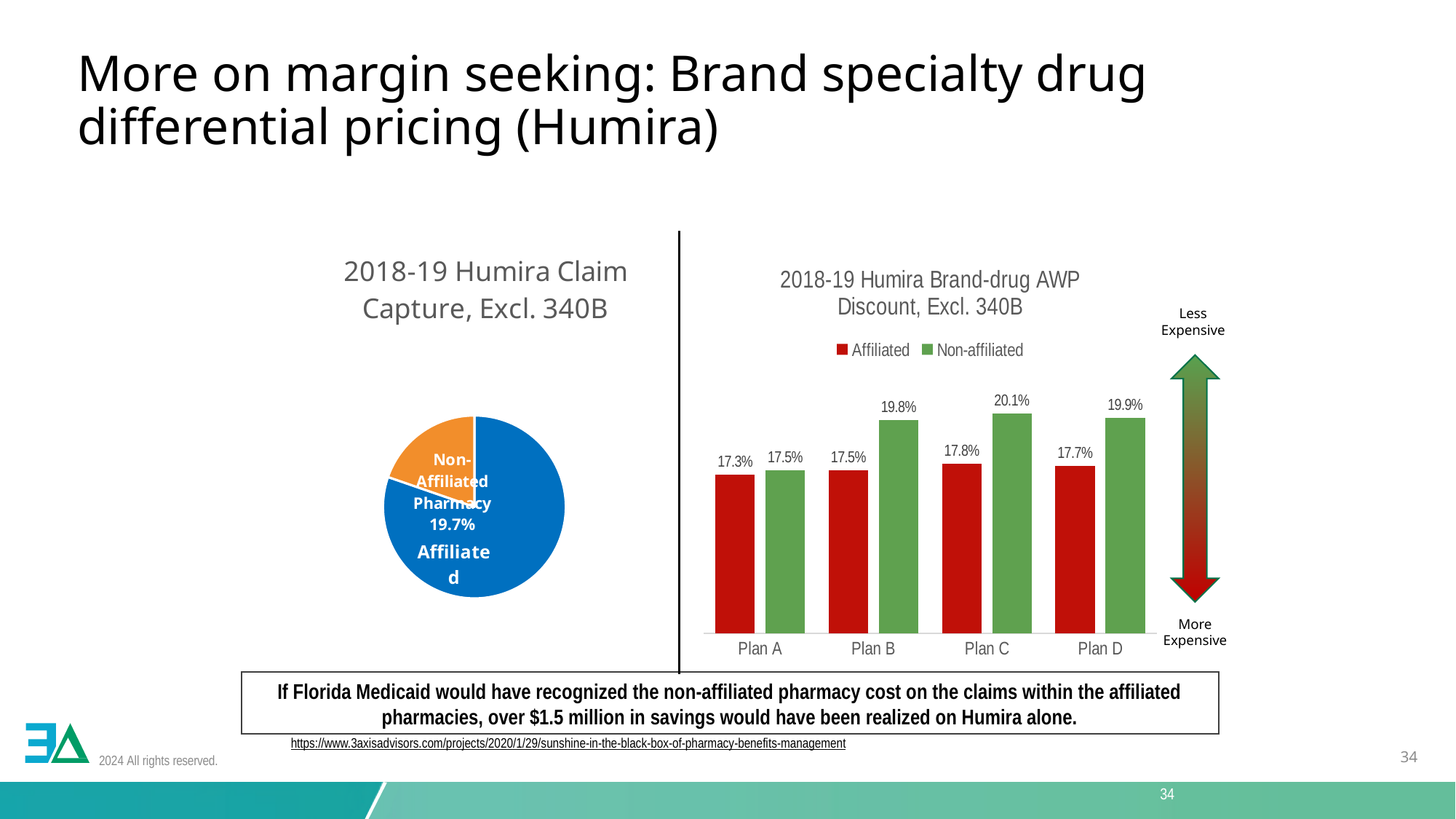
In the 2018-19 Humira Brand-drug AWP Discount chart, which plan has the lowest Affiliated discount? Plan A In the 2018-19 Humira Brand-drug AWP Discount chart, what is the Affiliated value for Plan A? 17.3% In the 2018-19 Humira Brand-drug AWP Discount chart, what is the difference between the Non-affiliated and Affiliated values for Plan B? 2.3% What kind of chart is the 2018-19 Humira Claim Capture, Excl. 340B chart? Pie chart How many series does the legend of the 2018-19 Humira Brand-drug AWP Discount chart list? 2 In the 2018-19 Humira Claim Capture pie chart, what share of claims is Non-Affiliated Pharmacy? 19.7% What kind of chart is the 2018-19 Humira Brand-drug AWP Discount, Excl. 340B chart? Bar chart In the 2018-19 Humira Brand-drug AWP Discount chart, which colour represents the Non-affiliated series? Green In the 2018-19 Humira Claim Capture pie chart, which slice is larger, Affiliated or Non-Affiliated Pharmacy? Affiliated In the 2018-19 Humira Brand-drug AWP Discount chart, how many plans are shown on the x axis? 4 In the 2018-19 Humira Brand-drug AWP Discount chart, what is the Non-affiliated value for Plan C? 20.1% In the 2018-19 Humira Brand-drug AWP Discount chart, which plan has the highest Non-affiliated discount? Plan C